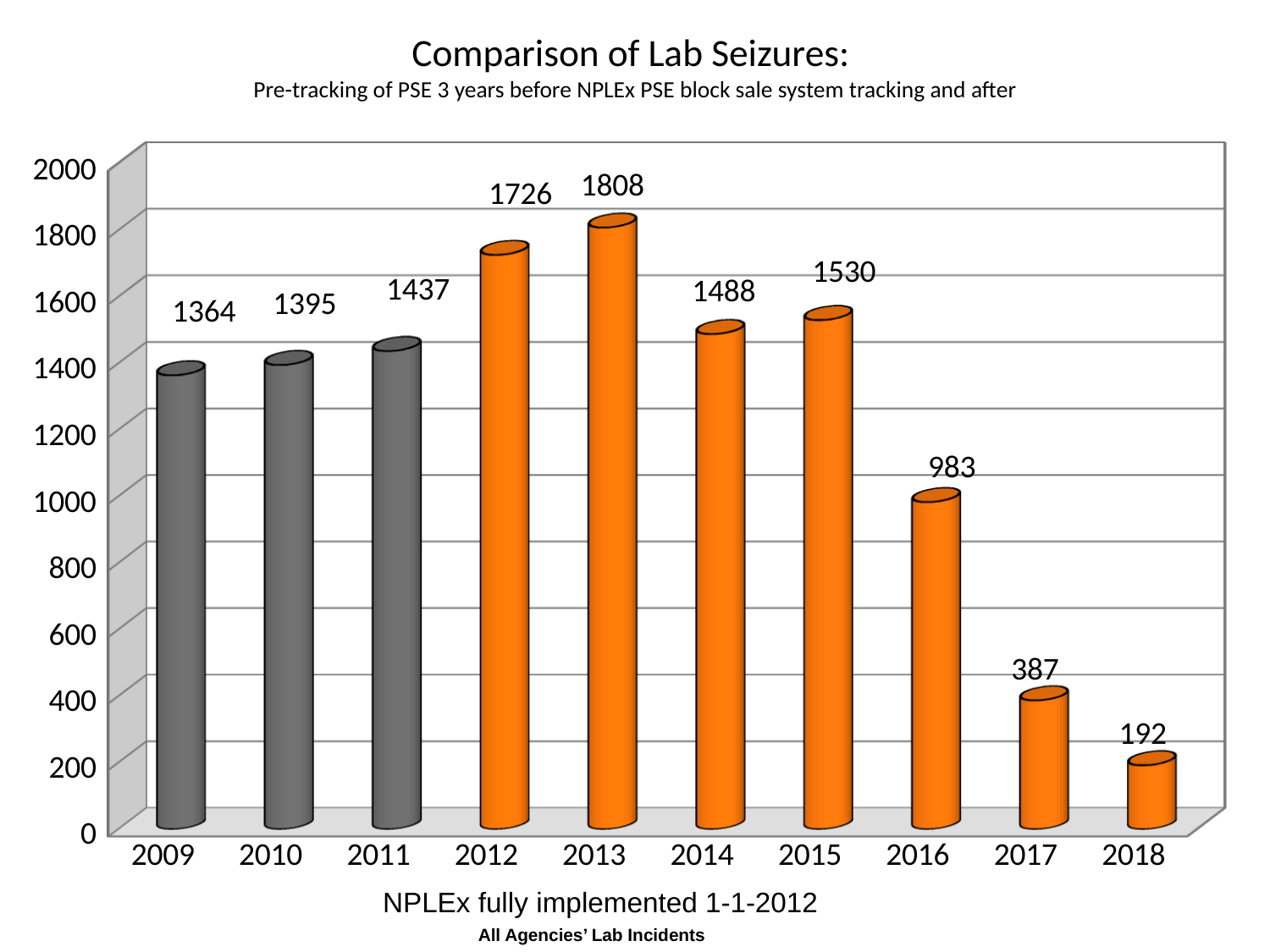
What is the difference between the values for 2013 and 2012? 82 What is the value for 2009? 1364 What is the value for 2013? 1808 What is the difference between the values for 2016 and 2017? 596 What is the value for 2018? 192 Is the value for 2016 greater or less than 1000? less Which year has the highest value? 2013 Which year has the lowest value? 2018 How many years are shown on the x axis? 10 Do the values rise or fall from 2015 to 2018? fall Which is larger, the value for 2014 or the value for 2015? 2015 What kind of chart is this? bar chart